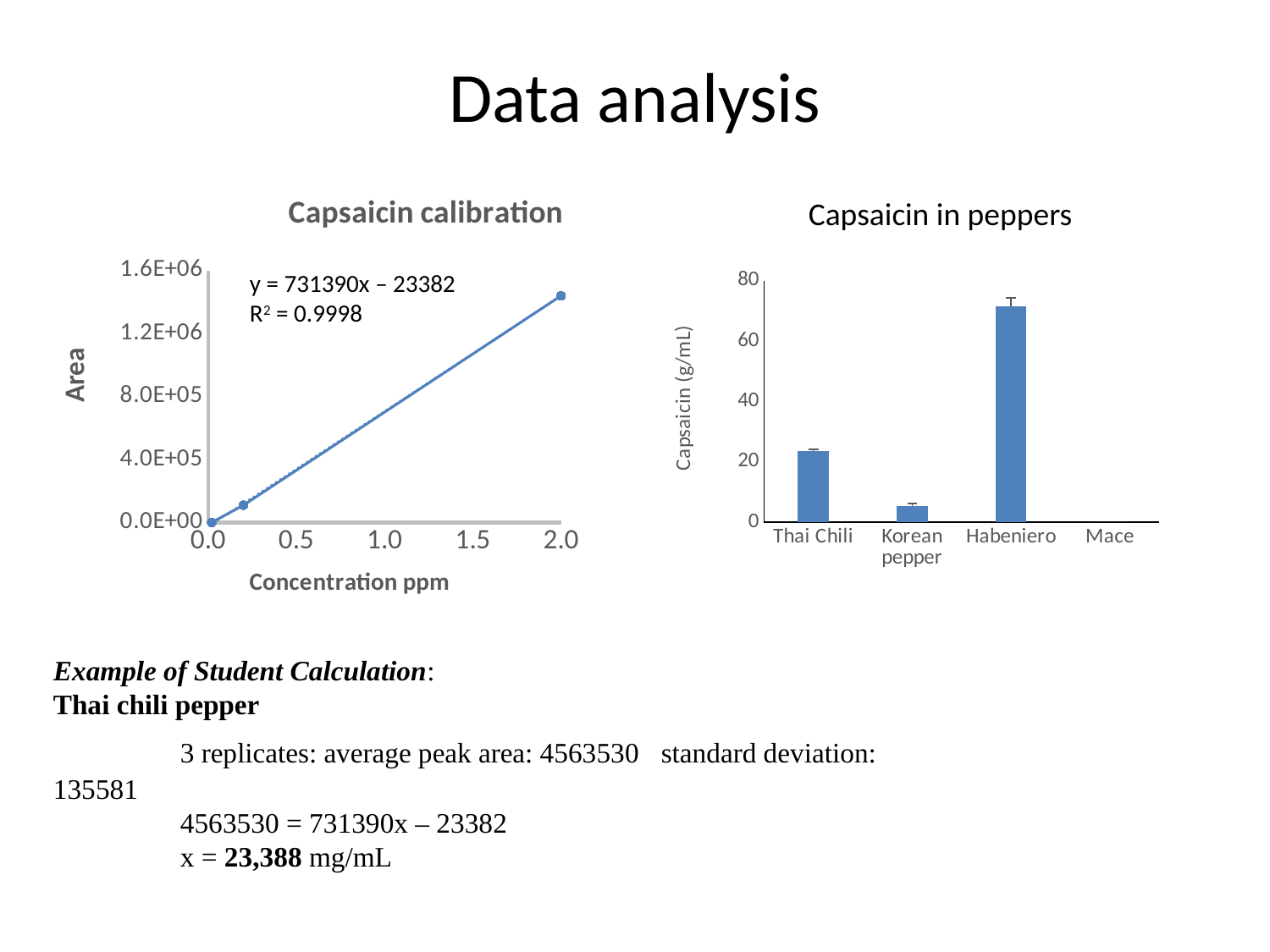
What type of chart is the "Capsaicin in peppers" chart? bar chart What R² value is shown on the "Capsaicin calibration" chart? 0.9998 In the "Capsaicin in peppers" chart, is the value for Korean pepper greater or less than 20? less How many data points are plotted in the "Capsaicin calibration" chart? 3 In the "Capsaicin in peppers" chart, which pepper has the highest capsaicin value? Habeniero In the "Capsaicin calibration" chart, do the values rise or fall as concentration increases? rise What is the y-axis label of the "Capsaicin in peppers" chart? Capsaicin (g/mL) In the "Capsaicin in peppers" chart, is the value for Habeniero greater or less than 60? greater In the "Capsaicin in peppers" chart, which category has the lowest capsaicin value? Mace In the "Capsaicin in peppers" chart, is the value for Thai Chili greater or less than 40? less In the "Capsaicin in peppers" chart, which has a larger capsaicin value, Thai Chili or Korean pepper? Thai Chili How many categories are shown on the x axis of the "Capsaicin in peppers" chart? 4